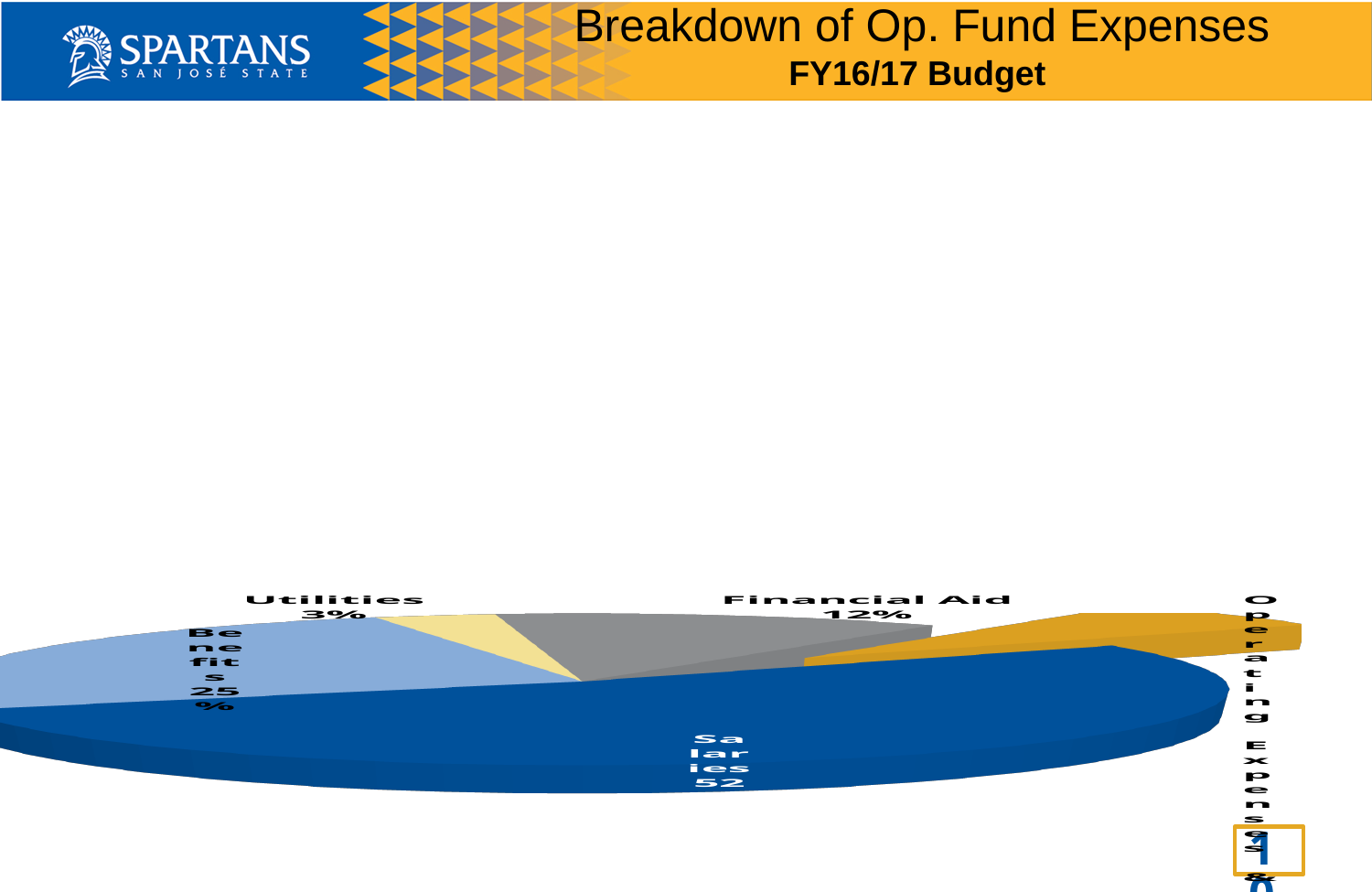
Which category has the largest slice of the pie? Salaries How many percentage points larger is Financial Aid than Utilities? 9% Which is larger, the Salaries slice or the Benefits slice? Salaries What share of Op. Fund expenses is Utilities? 3% Which is larger, the Benefits share or the Financial Aid share? Benefits Which category has the smallest slice of the pie? Utilities What is the title of the slide containing the chart? Breakdown of Op. Fund Expenses What share of Op. Fund expenses is Benefits? 25% What kind of chart is shown on the slide? pie chart What share of Op. Fund expenses is Financial Aid? 12% How many slices does the pie chart have? 5 How many percentage points larger is Benefits than Financial Aid? 13%